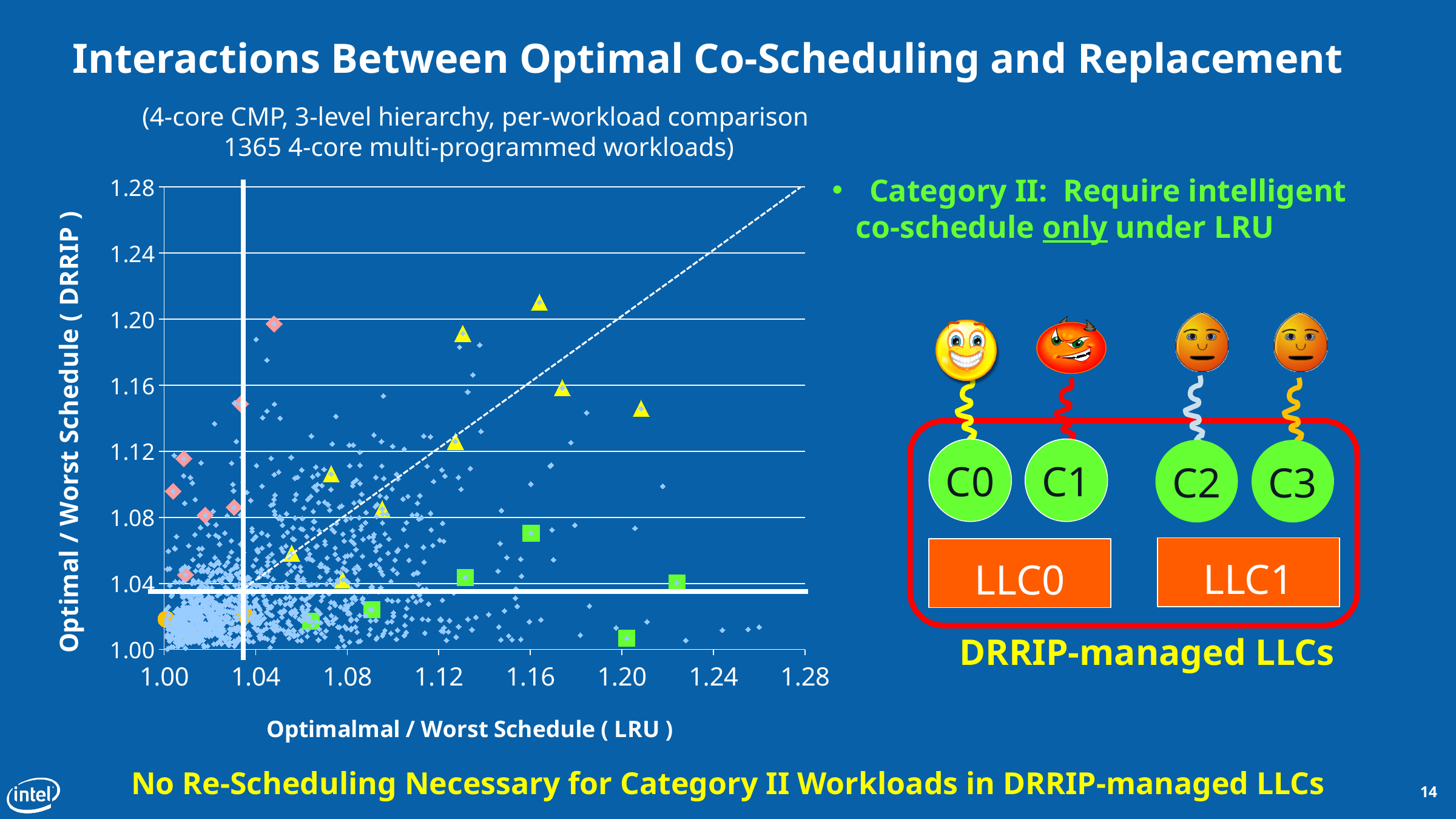
What is the title of the horizontal axis of the chart? Optimalmal / Worst Schedule ( LRU ) According to the chart's subtitle, how many 4-core multi-programmed workloads are plotted? 1365 What is the title of the vertical axis of the chart? Optimal / Worst Schedule ( DRRIP ) What kind of chart is shown on the slide? Scatter chart What is the lowest tick value shown on the horizontal axis of the chart? 1.00 What is the highest tick value shown on the vertical axis of the chart? 1.28